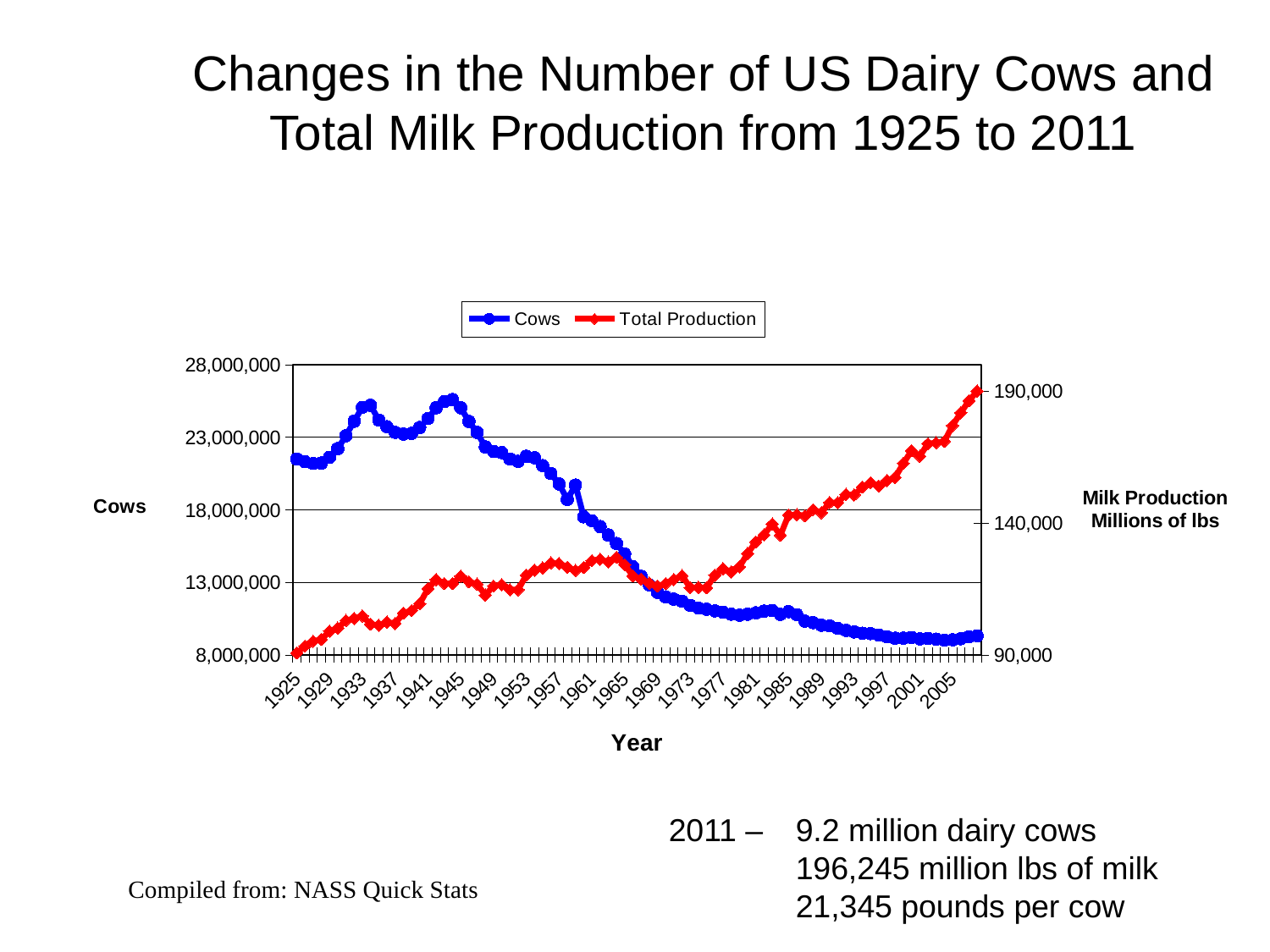
Is the value for Cows in 2005 greater or less than 13,000,000? less Does the Total Production series generally rise or fall from 1925 to 2011? Rise Is the value for Cows in 1925 greater or less than 18,000,000? greater How many series does the chart's legend list? 2 Is the value for Total Production in 2005 greater or less than 140,000? greater What is the title of the right-hand vertical axis of the chart? Milk Production Millions of lbs What are the two series named in the chart's legend? Cows and Total Production Does the Cows series rise or fall from 1945 to 2011? Fall What kind of chart is shown on the slide? Line chart Which is larger, the number of Cows in 1945 or in 1985? 1945